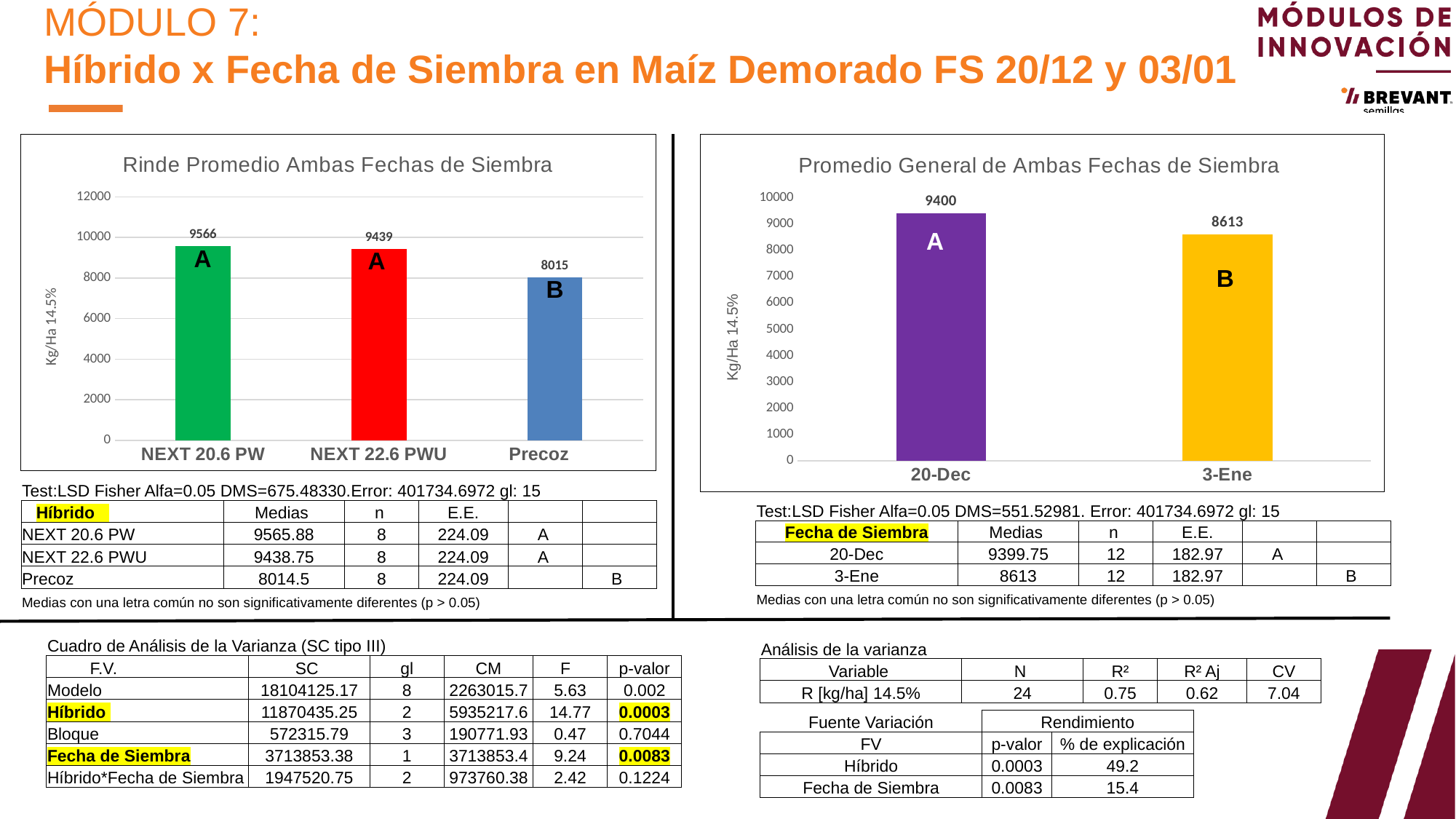
In the chart 'Rinde Promedio Ambas Fechas de Siembra', what is the difference between NEXT 20.6 PW and Precoz? 1551 What kind of chart is 'Promedio General de Ambas Fechas de Siembra'? bar chart In the chart 'Promedio General de Ambas Fechas de Siembra', which category has the highest value? 20-Dec In the chart 'Promedio General de Ambas Fechas de Siembra', what is the value for 20-Dec? 9400 In the chart 'Rinde Promedio Ambas Fechas de Siembra', is the value for NEXT 22.6 PWU greater or less than 8000? greater In the chart 'Rinde Promedio Ambas Fechas de Siembra', what is the y-axis label? Kg/Ha 14.5% In the chart 'Promedio General de Ambas Fechas de Siembra', what is the difference between 20-Dec and 3-Ene? 787 In the chart 'Rinde Promedio Ambas Fechas de Siembra', what is the value for Precoz? 8015 In the chart 'Rinde Promedio Ambas Fechas de Siembra', how many categories are plotted? 3 In the chart 'Rinde Promedio Ambas Fechas de Siembra', what is the value for NEXT 20.6 PW? 9566 In the chart 'Rinde Promedio Ambas Fechas de Siembra', which category has the lowest value? Precoz In the chart 'Promedio General de Ambas Fechas de Siembra', what is the value for 3-Ene? 8613